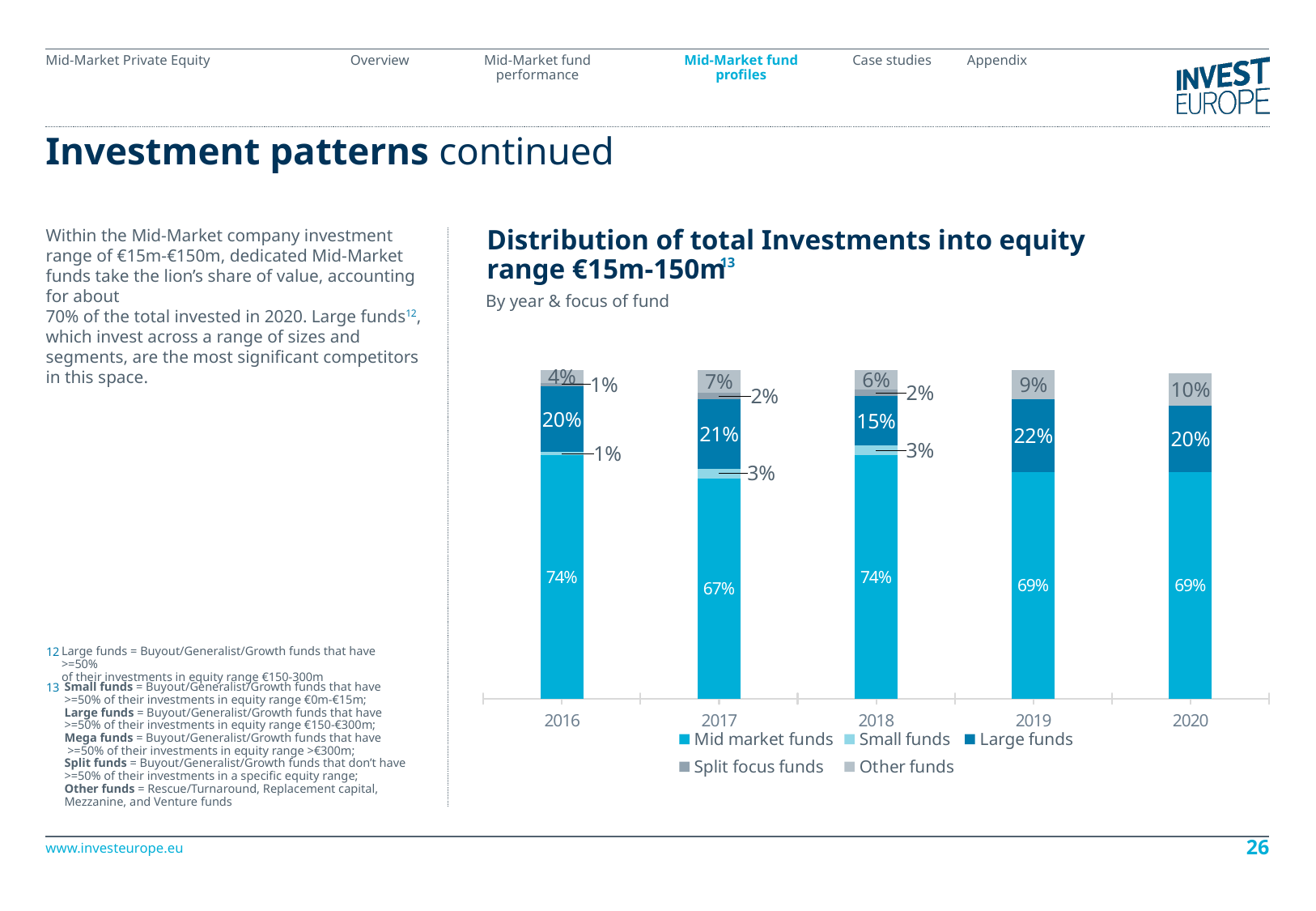
How many years are shown on the x axis? 5 What was the Other funds share in 2017? 7% What kind of chart is shown on the slide? Stacked bar chart What share of total investments into the €15m-150m equity range did Mid market funds account for in 2020? 69% What was the Small funds share in 2018? 3% How many series does the legend list? 5 In which year was the Mid market funds share lowest? 2017 Which year had the larger Mid market funds share, 2017 or 2019? 2019 In which year was the Large funds share highest? 2019 What was the Large funds share in 2019? 22% In which year was the Other funds share lowest? 2016 By how many percentage points did the Large funds share in 2019 exceed that in 2018? 7 percentage points